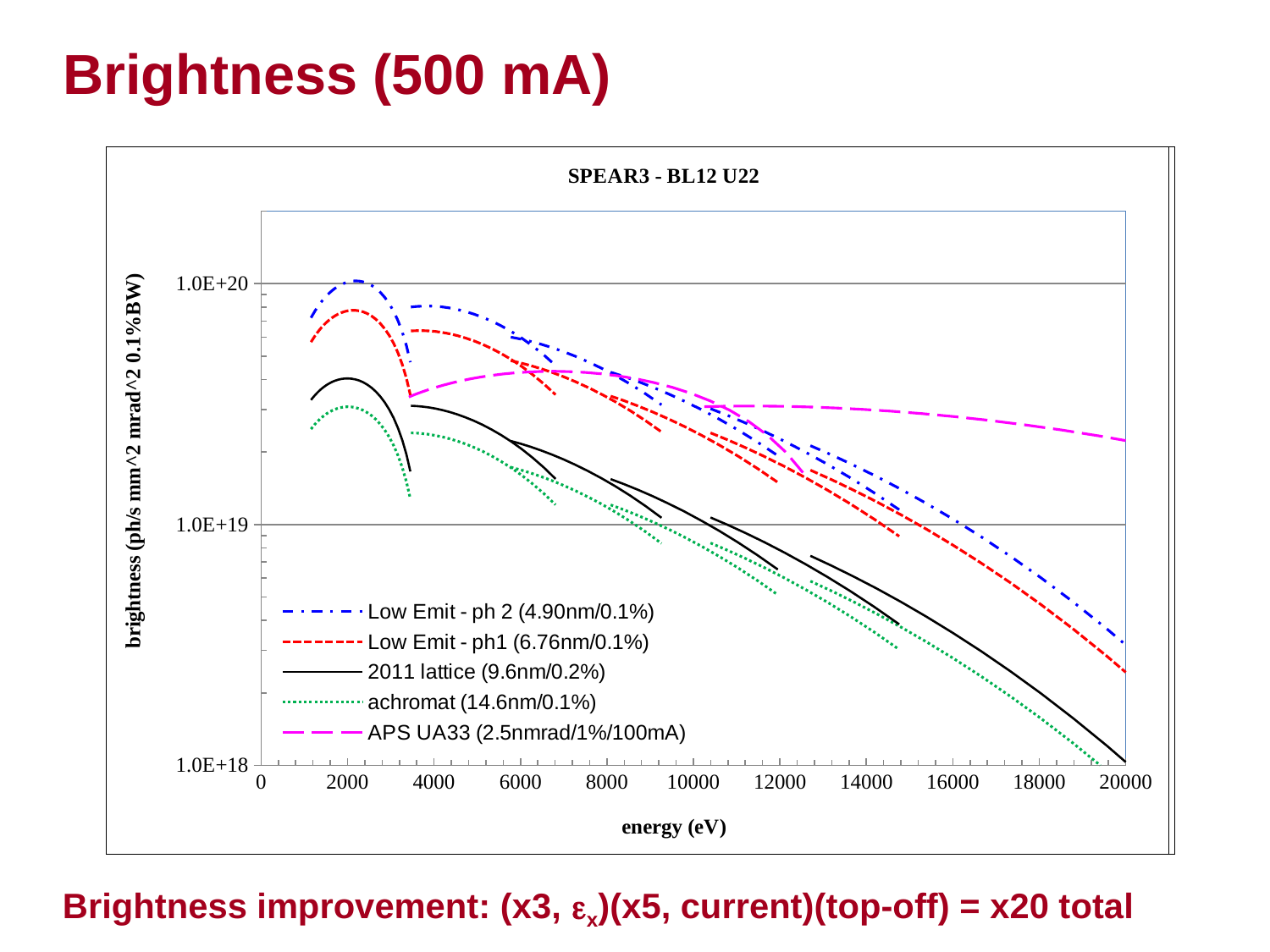
What kind of chart is shown on the slide? line chart How many series does the chart legend list? 5 Is the peak brightness of the 2011 lattice series greater or less than 1.0E+19? greater Which series has the highest brightness at 20000 eV? APS UA33 (2.5nmrad/1%/100mA) Is the peak brightness of Low Emit - ph1 greater or less than 1.0E+20? less What is the title of the chart? SPEAR3 - BL12 U22 Is the brightness of APS UA33 at 20000 eV greater or less than 1.0E+19? greater At 20000 eV, which is higher: Low Emit - ph 2 or Low Emit - ph1? Low Emit - ph 2 Which series reaches the highest peak brightness on the chart? Low Emit - ph 2 (4.90nm/0.1%) Above about 4000 eV, does the brightness of the 2011 lattice series rise or fall as energy increases? fall What is the label of the x axis? energy (eV)